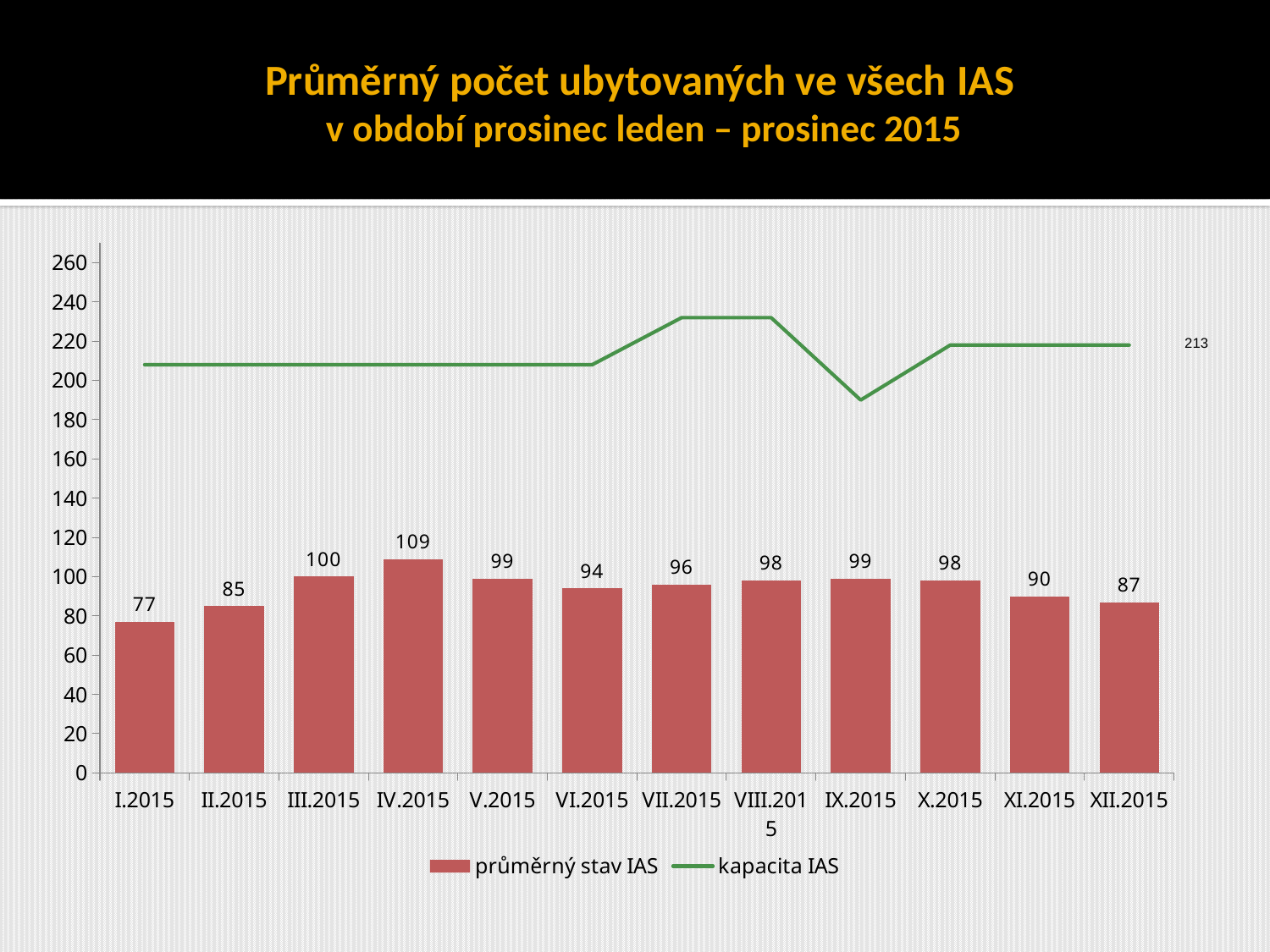
Is the kapacita IAS value for VII.2015 greater or less than 220? greater What is the value of průměrný stav IAS for I.2015? 77 Which month has the lowest průměrný stav IAS? I.2015 Which month has the highest průměrný stav IAS? IV.2015 What is the difference between the průměrný stav IAS for IV.2015 and I.2015? 32 What is the value of průměrný stav IAS for IV.2015? 109 How many months are shown on the x axis? 12 What is the value of průměrný stav IAS for XI.2015? 90 Which is larger, the průměrný stav IAS for III.2015 or for XII.2015? III.2015 What colour is the kapacita IAS line? Green Is the kapacita IAS value for IX.2015 greater or less than 200? less How many series does the legend list? 2